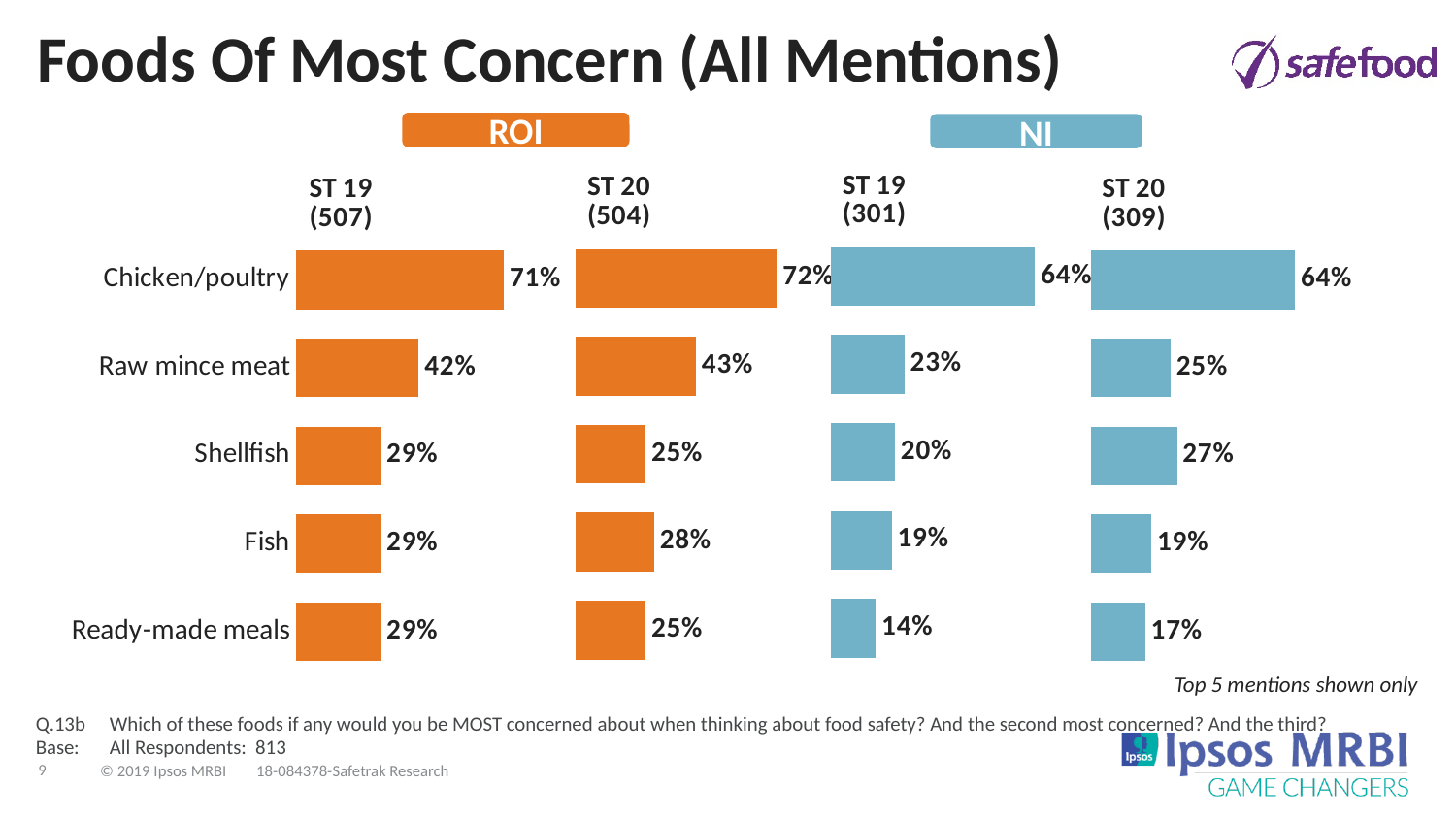
In the ROI ST 20 (504) chart, which food has the highest value? Chicken/poultry In the NI ST 19 (301) chart, which food has the lowest value? Ready-made meals What kind of chart is used on this slide? Bar chart In the NI ST 20 (309) chart, what is the difference between Chicken/poultry and Fish? 45 percentage points In the ROI ST 20 (504) chart, what is the value for Raw mince meat? 43% How many food categories are shown in each chart? 5 In the ROI ST 19 (507) chart, what is the value for Chicken/poultry? 71% What colour are the bars for the NI charts? Blue Which is larger: the NI ST 19 (301) value for Shellfish or the NI ST 20 (309) value for Shellfish? NI ST 20 (309) In the NI ST 20 (309) chart, what is the value for Shellfish? 27% What is the title of the slide's chart? Foods Of Most Concern (All Mentions) What is the difference between the ROI ST 19 (507) value and the NI ST 19 (301) value for Raw mince meat? 19 percentage points